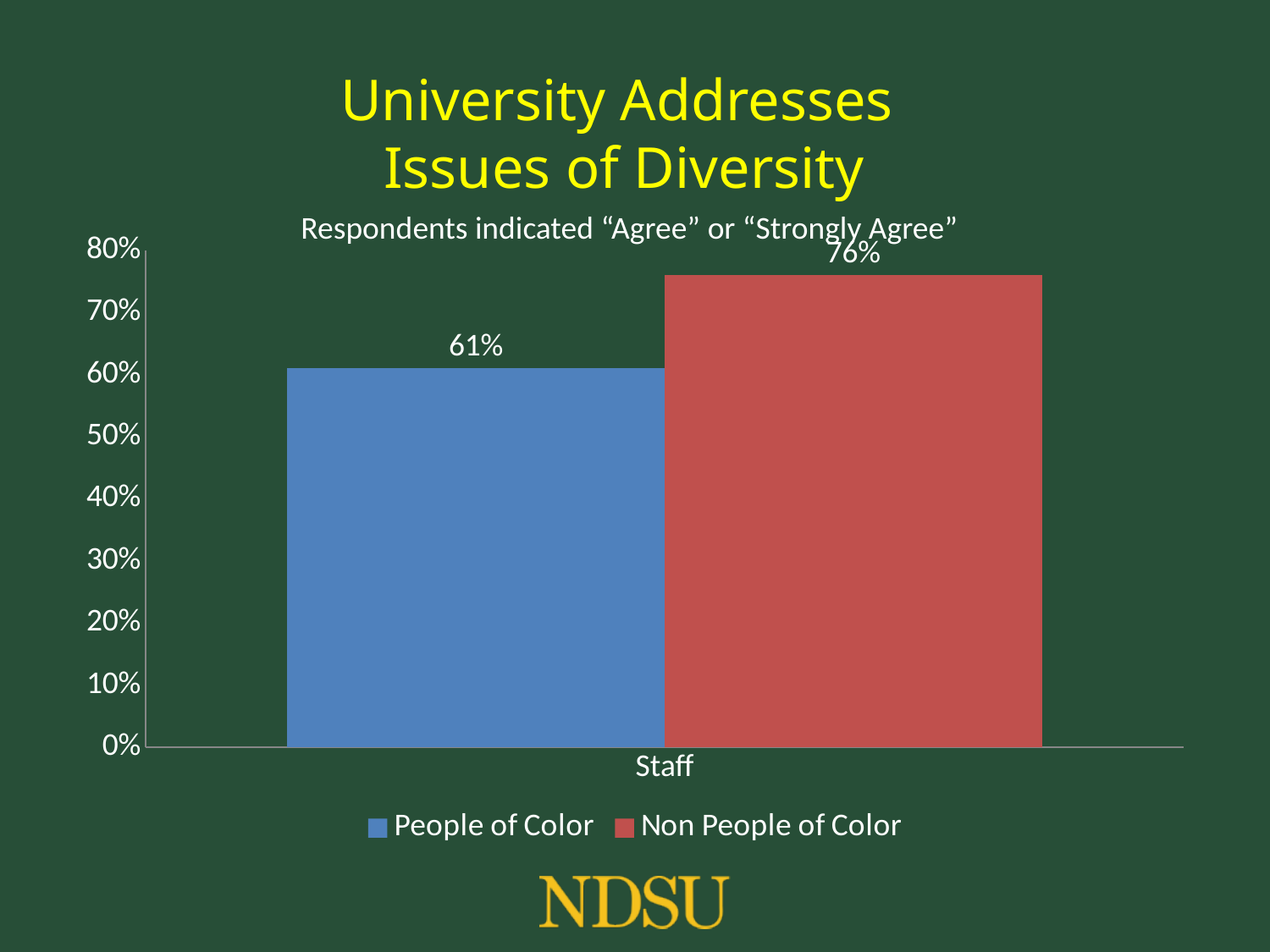
What percentage of Non People of Color staff respondents indicated "Agree" or "Strongly Agree"? 76% How many series does the legend list? 2 Which series has the higher value for Staff? Non People of Color What kind of chart is shown on the slide? Bar chart Is the value for People of Color greater or less than 70%? less Which series has the lower value for Staff? People of Color Which colour represents Non People of Color in the chart? Red What percentage of People of Color staff respondents indicated "Agree" or "Strongly Agree"? 61% Is the value for Non People of Color greater or less than 70%? greater What is the category label on the x axis? Staff How many categories are shown on the x axis? 1 What is the difference in percentage points between Non People of Color and People of Color for Staff? 15